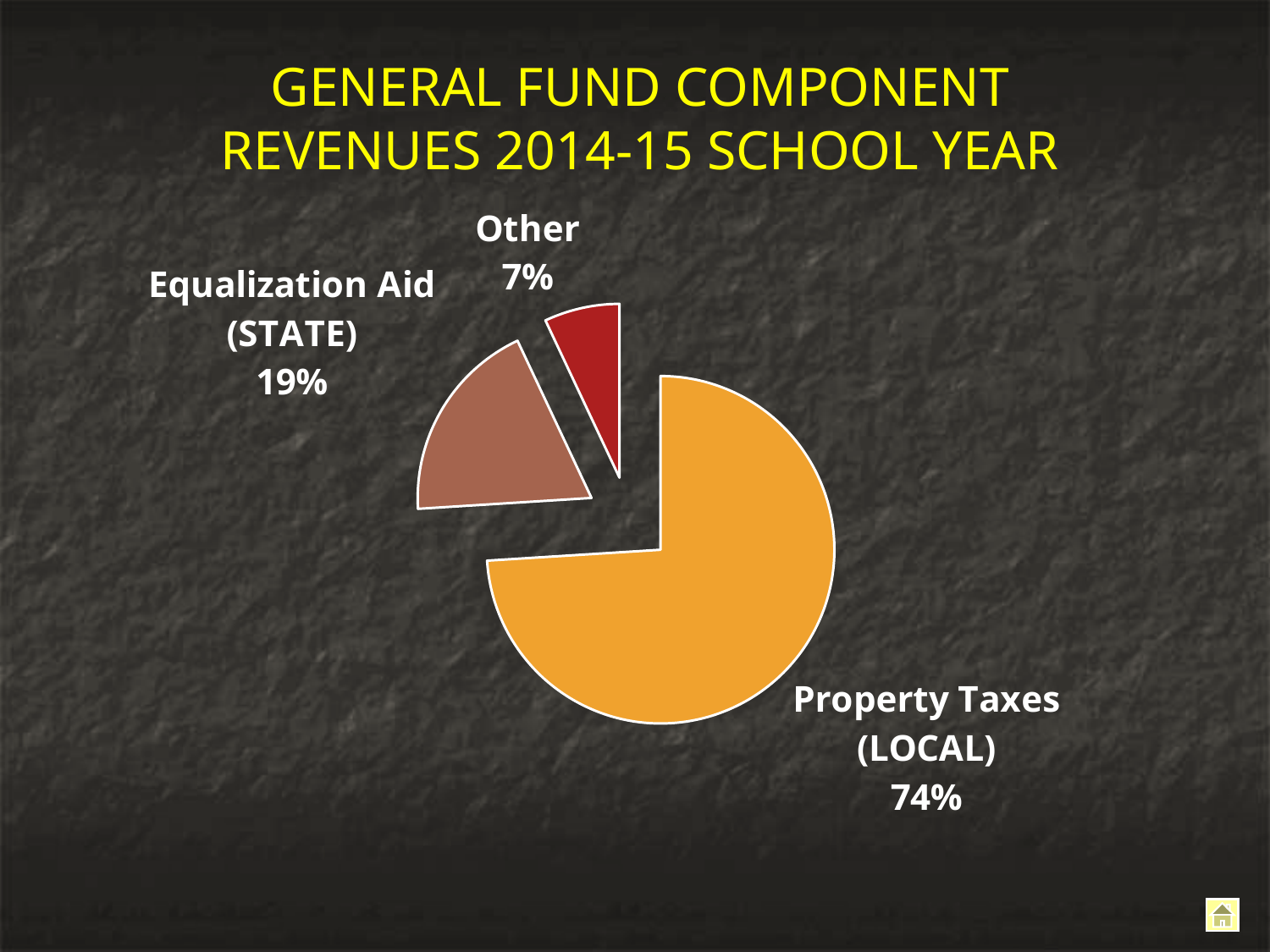
Which revenue component has the smallest share of the pie? Other What is the title of the chart on the slide? GENERAL FUND COMPONENT REVENUES 2014-15 SCHOOL YEAR What share of general fund component revenues is labelled Other? 7% Which revenue component has the largest share of the pie? Property Taxes (LOCAL) What colour is the Property Taxes (LOCAL) slice? orange Which is larger, the share for Equalization Aid (STATE) or the share for Other? Equalization Aid (STATE) How many slices does the pie chart have? 3 What share of general fund component revenues comes from Property Taxes (LOCAL)? 74% What kind of chart is shown on the slide? pie chart What share of general fund component revenues comes from Equalization Aid (STATE)? 19% What is the difference in percentage points between Property Taxes (LOCAL) and Equalization Aid (STATE)? 55 What is the difference in percentage points between Equalization Aid (STATE) and Other? 12